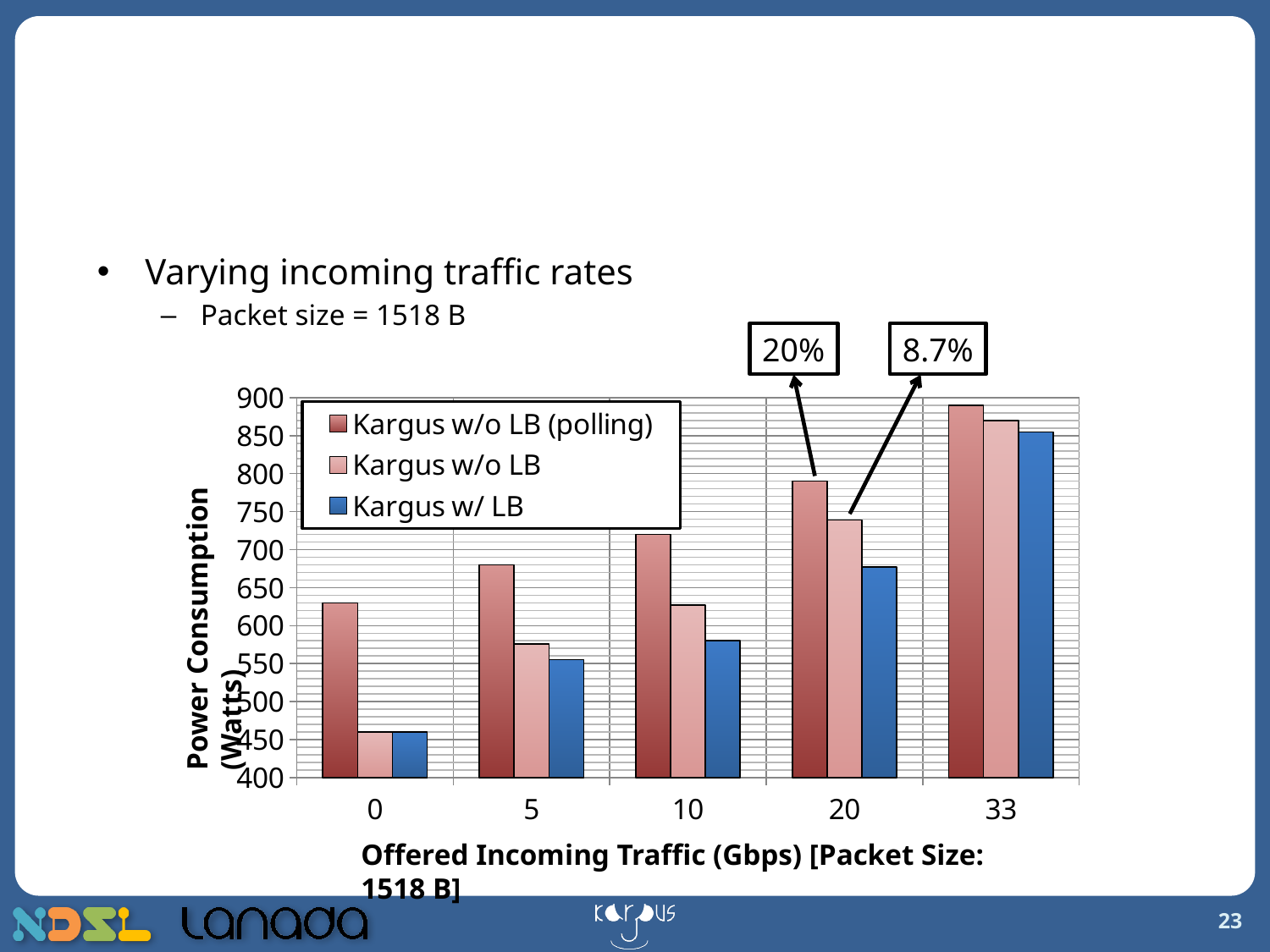
Is the value for Kargus w/ LB at 0 Gbps greater or less than 500? less Is the value for Kargus w/o LB (polling) at 0 Gbps greater or less than 600? greater What is the title of the y axis? Power Consumption (Watts) How many series does the legend list? 3 What kind of chart is shown on the slide? bar chart What percentage is shown in the annotation box pointing to the Kargus w/o LB (polling) bar at 20 Gbps? 20% At 0 Gbps, which series has the higher power consumption: Kargus w/o LB (polling) or Kargus w/ LB? Kargus w/o LB (polling) At which offered incoming traffic rate is the Kargus w/ LB power consumption lowest? 0 Does the power consumption for Kargus w/ LB rise or fall as the offered incoming traffic increases? rise At which offered incoming traffic rate is the Kargus w/o LB (polling) power consumption highest? 33 At 20 Gbps, which series has the higher power consumption: Kargus w/o LB or Kargus w/ LB? Kargus w/o LB How many offered incoming traffic rates are shown on the x axis? 5